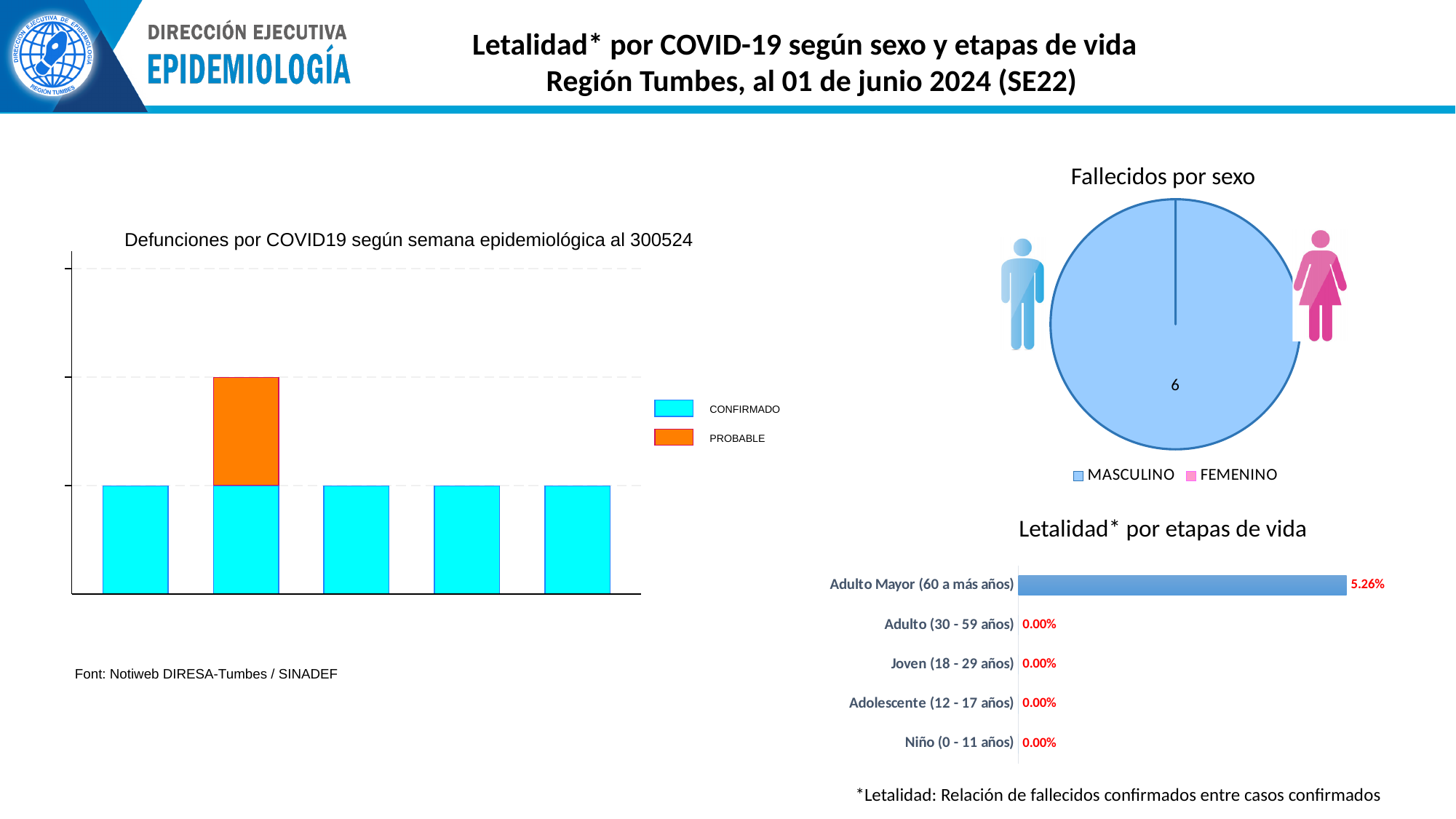
In the 'Letalidad* por etapas de vida' chart, what is the value for Adulto Mayor (60 a más años)? 5.26% In the 'Letalidad* por etapas de vida' chart, what is the difference between the values for Adulto Mayor (60 a más años) and Niño (0 - 11 años)? 5.26% How many age-group categories are shown in the 'Letalidad* por etapas de vida' chart? 5 How many bars are plotted in the 'Defunciones por COVID19 según semana epidemiológica al 300524' chart? 5 In the 'Fallecidos por sexo' chart, what value is printed on the MASCULINO slice? 6 In the 'Letalidad* por etapas de vida' chart, is the value for Adulto Mayor (60 a más años) larger or smaller than the value for Joven (18 - 29 años)? Larger What kind of chart is 'Fallecidos por sexo'? Pie chart How many series does the legend of the 'Defunciones por COVID19 según semana epidemiológica al 300524' chart list? 2 How many entries does the legend of the 'Fallecidos por sexo' chart list? 2 In the 'Letalidad* por etapas de vida' chart, what is the value for Adulto (30 - 59 años)? 0.00% In the 'Letalidad* por etapas de vida' chart, which age group has the highest value? Adulto Mayor (60 a más años) What kind of chart is 'Letalidad* por etapas de vida'? Bar chart